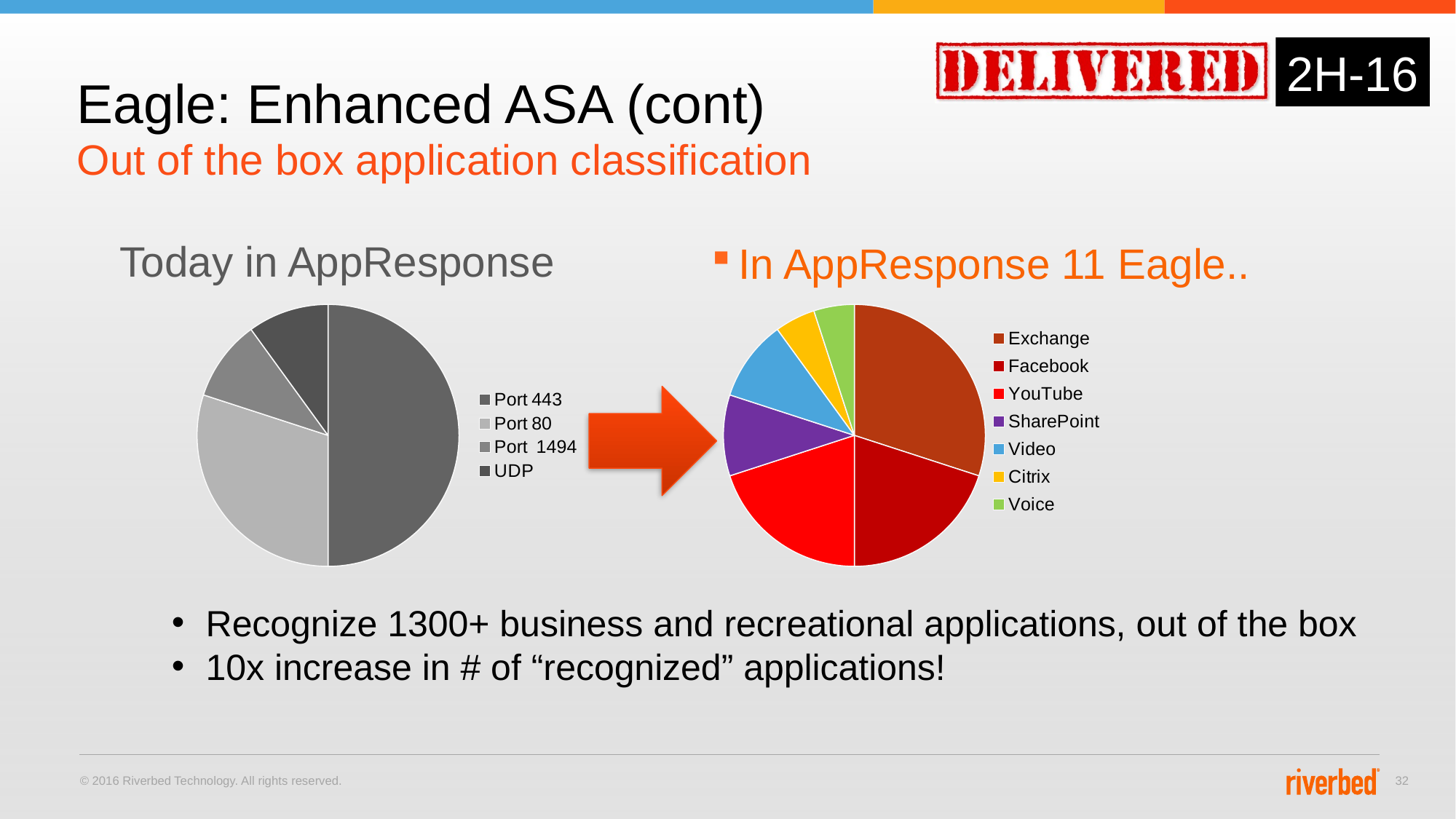
How many slices does the "Today in AppResponse" pie chart have? 4 What kind of chart is the "Today in AppResponse" chart? pie chart What are the legend entries of the "Today in AppResponse" pie chart? Port 443, Port 80, Port 1494, UDP In the "In AppResponse 11 Eagle.." pie chart, what colour is the Video slice? blue In the "Today in AppResponse" pie chart, which slice is larger, Port 443 or Port 80? Port 443 What kind of chart is the "In AppResponse 11 Eagle.." chart? pie chart In the "Today in AppResponse" pie chart, which category has the largest slice? Port 443 In the "In AppResponse 11 Eagle.." pie chart, which slice is larger, Facebook or Video? Facebook In the "In AppResponse 11 Eagle.." pie chart, which slice is larger, YouTube or SharePoint? YouTube In the "In AppResponse 11 Eagle.." pie chart, which category has the largest slice? Exchange How many slices does the "In AppResponse 11 Eagle.." pie chart have? 7